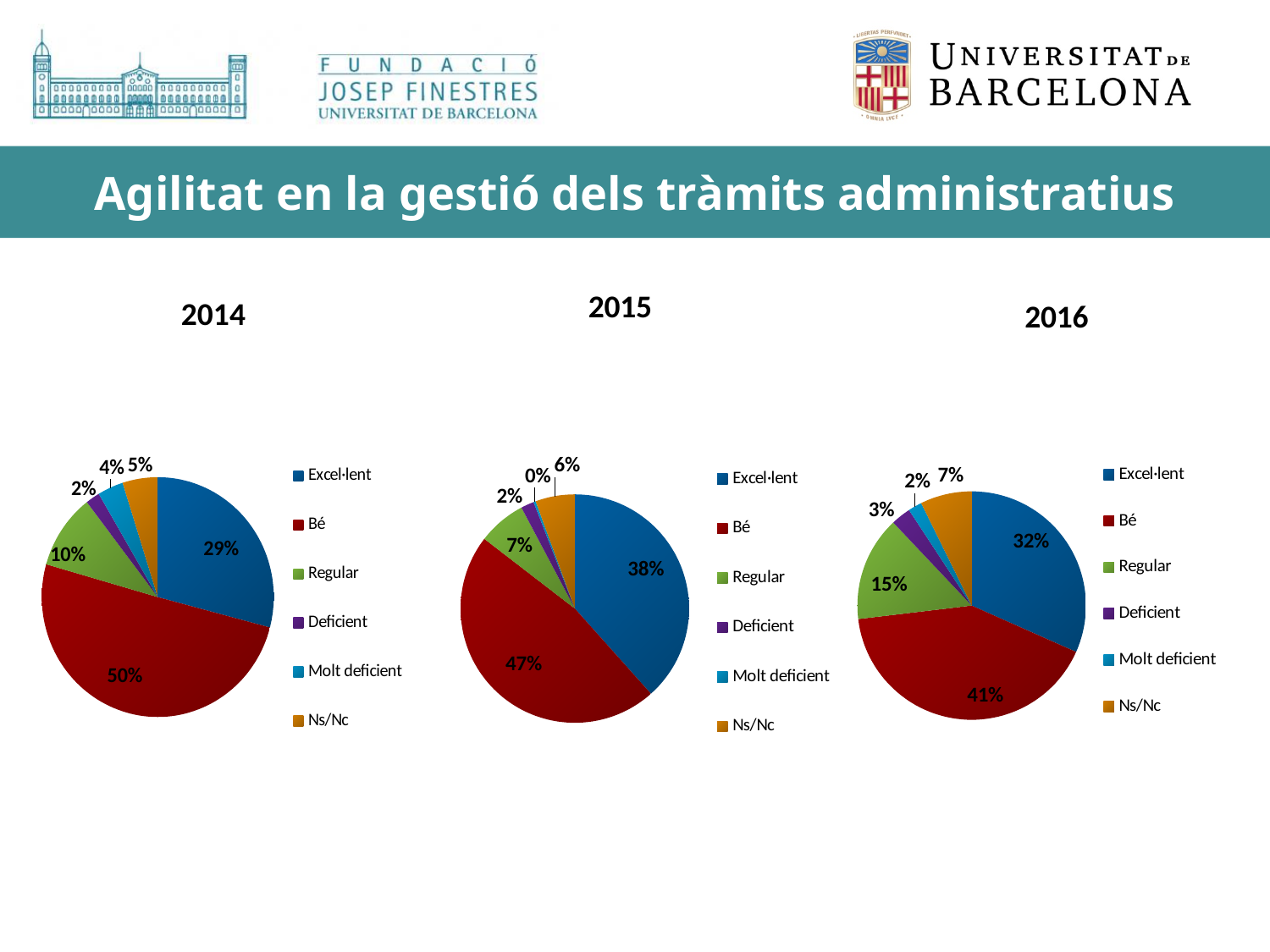
In the 2016 pie chart, what share does Regular have? 15% How many pie charts are shown on the slide? 3 In the 2014 pie chart, which category has the smallest slice? Deficient In the 2016 pie chart, what is the difference between the Bé and Excel·lent shares? 9% How many categories does the legend of the 2014 pie chart list? 6 What kind of chart is used for the 2015 data? Pie chart In the 2015 pie chart, which is larger, the Regular slice or the Ns/Nc slice? Regular In the 2015 pie chart, what share does Molt deficient have? 0% In the 2015 pie chart, what share does Excel·lent have? 38% In the 2016 pie chart, which category has the largest slice? Bé In the 2014 pie chart, what share does Ns/Nc have? 5% In the 2014 pie chart, what share does Bé have? 50%